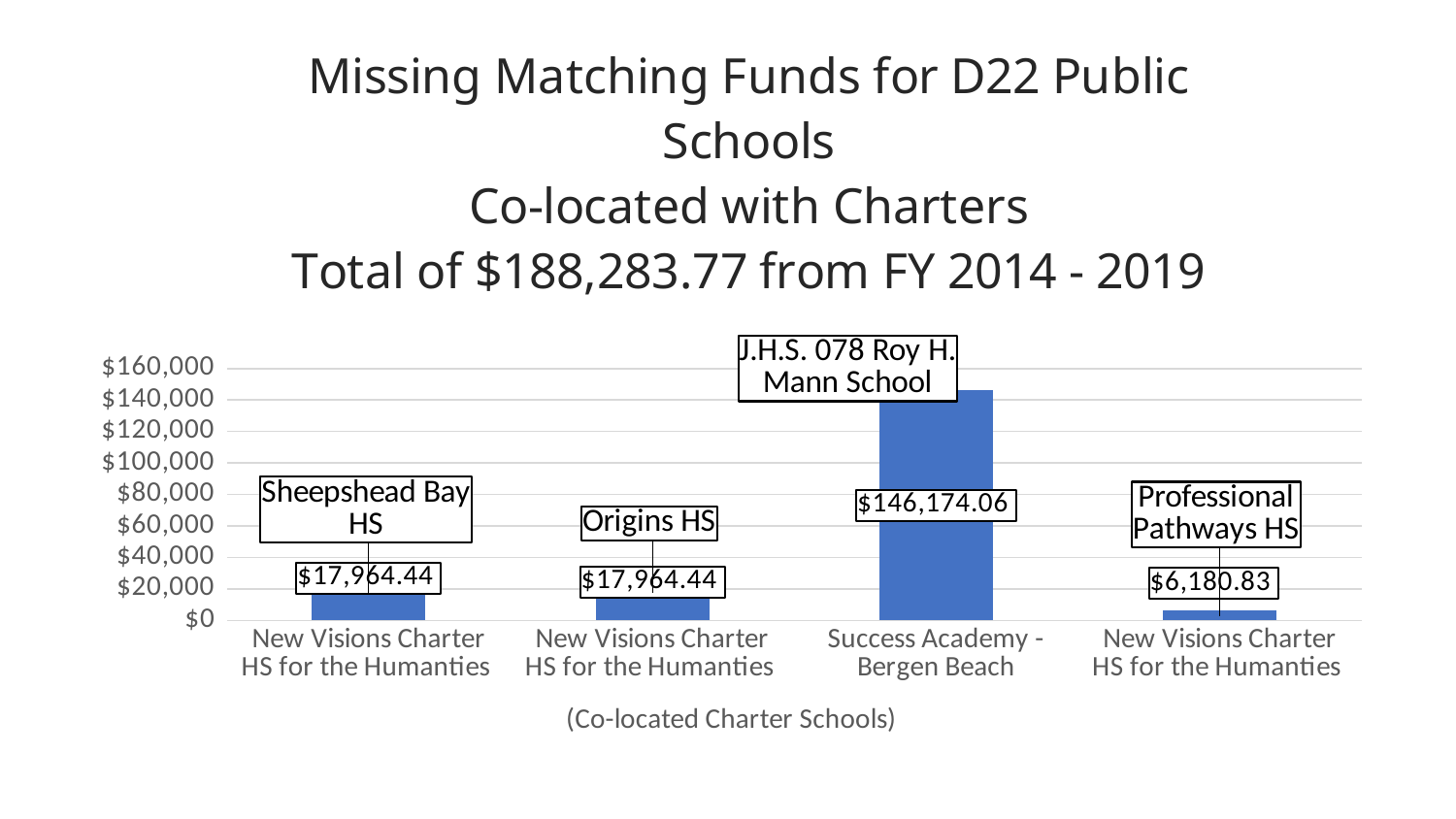
What is the missing matching funds value shown for Origins HS? $17,964.44 What is the missing matching funds value shown for J.H.S. 078 Roy H. Mann School? $146,174.06 What is the missing matching funds value shown for Sheepshead Bay HS? $17,964.44 What is the missing matching funds value shown for Professional Pathways HS? $6,180.83 Which school has the lowest missing matching funds value? Professional Pathways HS How many bars are plotted in the chart? 4 What type of chart is shown on the slide? bar chart Is the value for J.H.S. 078 Roy H. Mann School greater or less than $140,000? greater What is the difference between the values for J.H.S. 078 Roy H. Mann School and Sheepshead Bay HS? $128,209.62 Which school has the highest missing matching funds value? J.H.S. 078 Roy H. Mann School Which is larger, the value for Sheepshead Bay HS or the value for Professional Pathways HS? Sheepshead Bay HS What is the difference between the values for Origins HS and Professional Pathways HS? $11,783.61